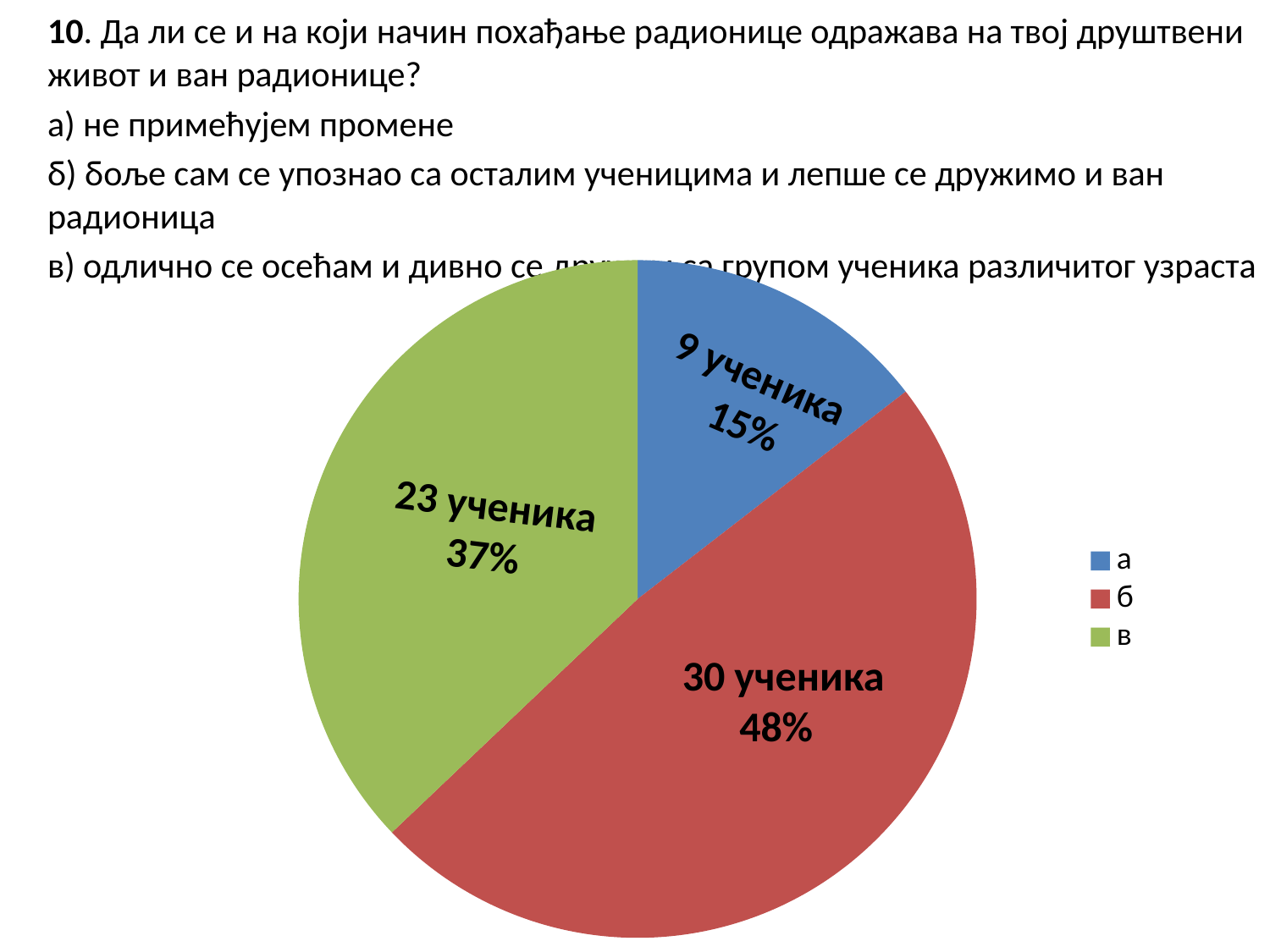
How many students chose option в? 23 ученика What percentage of the pie does option а represent? 15% Which option has the largest slice of the pie? б What colour is the slice for option в? green How many slices does the pie chart have? 3 Which option has the smallest slice of the pie? а How many students chose option а? 9 ученика Which option has more students, а or в? в What percentage of the pie does option б represent? 48% How many students chose option б? 30 ученика What kind of chart is shown on the slide? pie chart How many more students chose option б than option в? 7